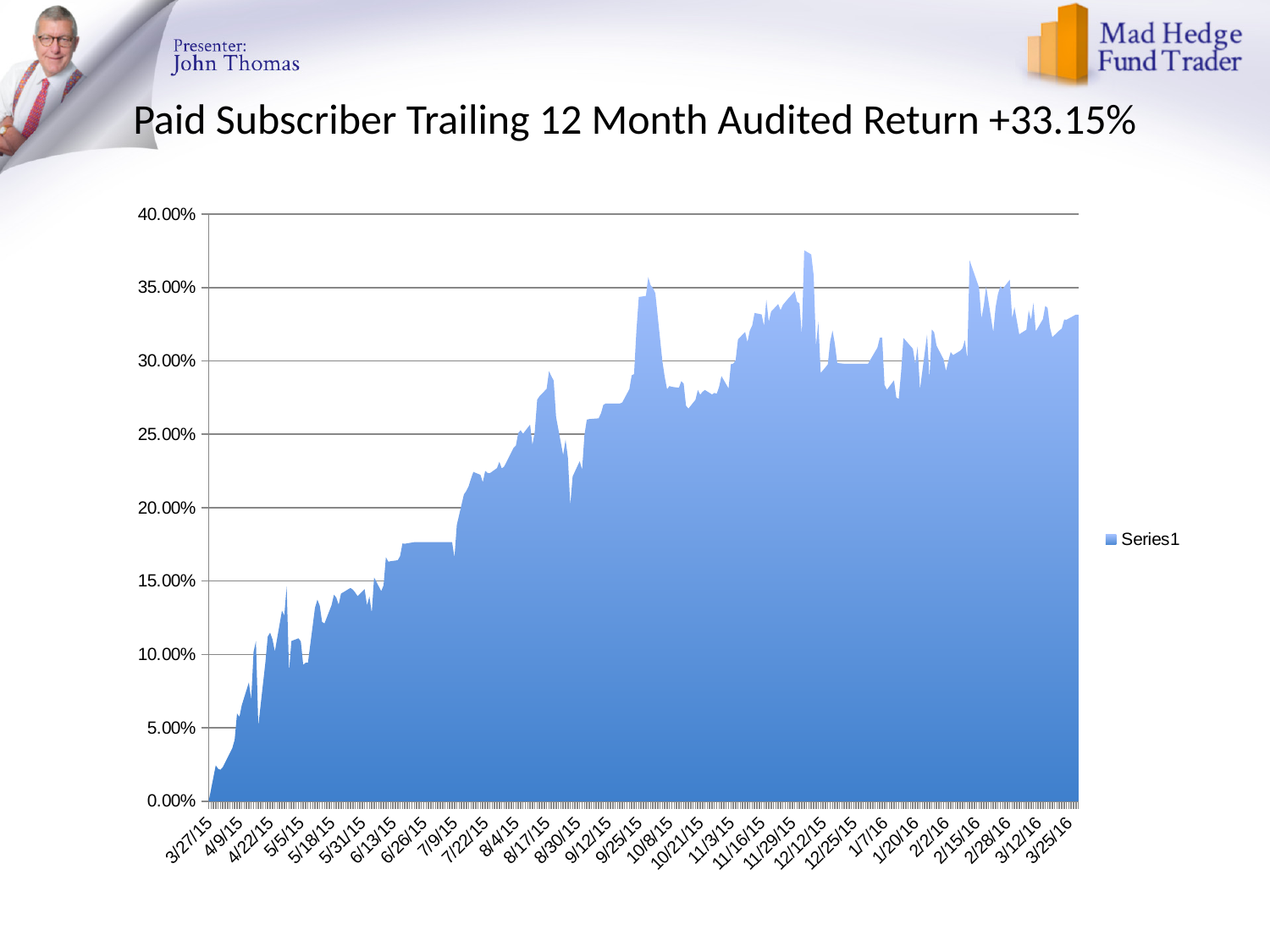
At which date on the x axis is the value lowest? 3/27/15 Is the value at 11/29/15 greater or less than 30.00%? greater How many series does the legend list? 1 Is the value at 7/9/15 greater or less than 20.00%? less Overall, do the values rise or fall from 3/27/15 to 3/25/16? rise Is the value at 4/9/15 greater or less than 10.00%? less What kind of chart is shown on the slide? area chart What return figure is stated in the chart's title? +33.15% Which is larger, the value at 3/27/15 or the value at 3/25/16? 3/25/16 What is the name of the series shown in the legend? Series1